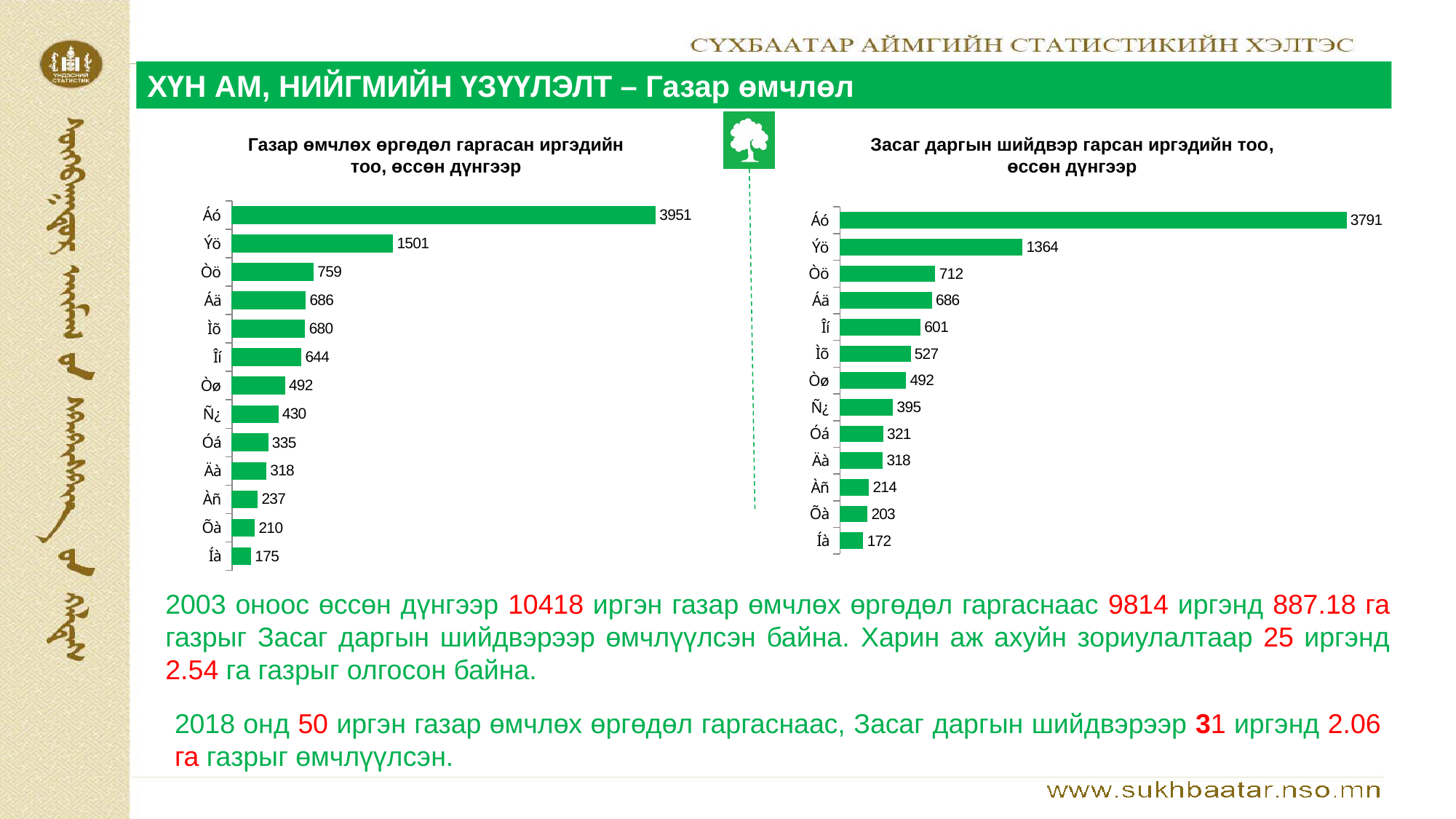
In the left chart (Газар өмчлөх өргөдөл гаргасан иргэдийн тоо), what is the difference between the values for Áó and Ýö? 2450 In the right chart (Засаг даргын шийдвэр гарсан иргэдийн тоо), what is the value of the top bar, labelled Áó? 3791 In the right chart (Засаг даргын шийдвэр гарсан иргэдийн тоо), what is the value of the bottom bar, labelled Íà? 172 In the left chart (Газар өмчлөх өргөдөл гаргасан иргэдийн тоо), what is the value of the top bar, labelled Áó? 3951 In the right chart (Засаг даргын шийдвэр гарсан иргэдийн тоо), what is the difference between the values for Ýö and Òö? 652 In the left chart (Газар өмчлөх өргөдөл гаргасан иргэдийн тоо), what is the value for Ýö? 1501 In the right chart (Засаг даргын шийдвэр гарсан иргэдийн тоо), which is larger, the value for Îí or the value for Ìõ? Îí What type of chart is the left chart titled "Газар өмчлөх өргөдөл гаргасан иргэдийн тоо, өссөн дүнгээр"? bar chart How many bar charts are shown on the slide? 2 In the left chart (Газар өмчлөх өргөдөл гаргасан иргэдийн тоо), how many categories are shown? 13 In the left chart (Газар өмчлөх өргөдөл гаргасан иргэдийн тоо), which category has the lowest value? Íà In the right chart (Засаг даргын шийдвэр гарсан иргэдийн тоо), what is the value for Òö? 712